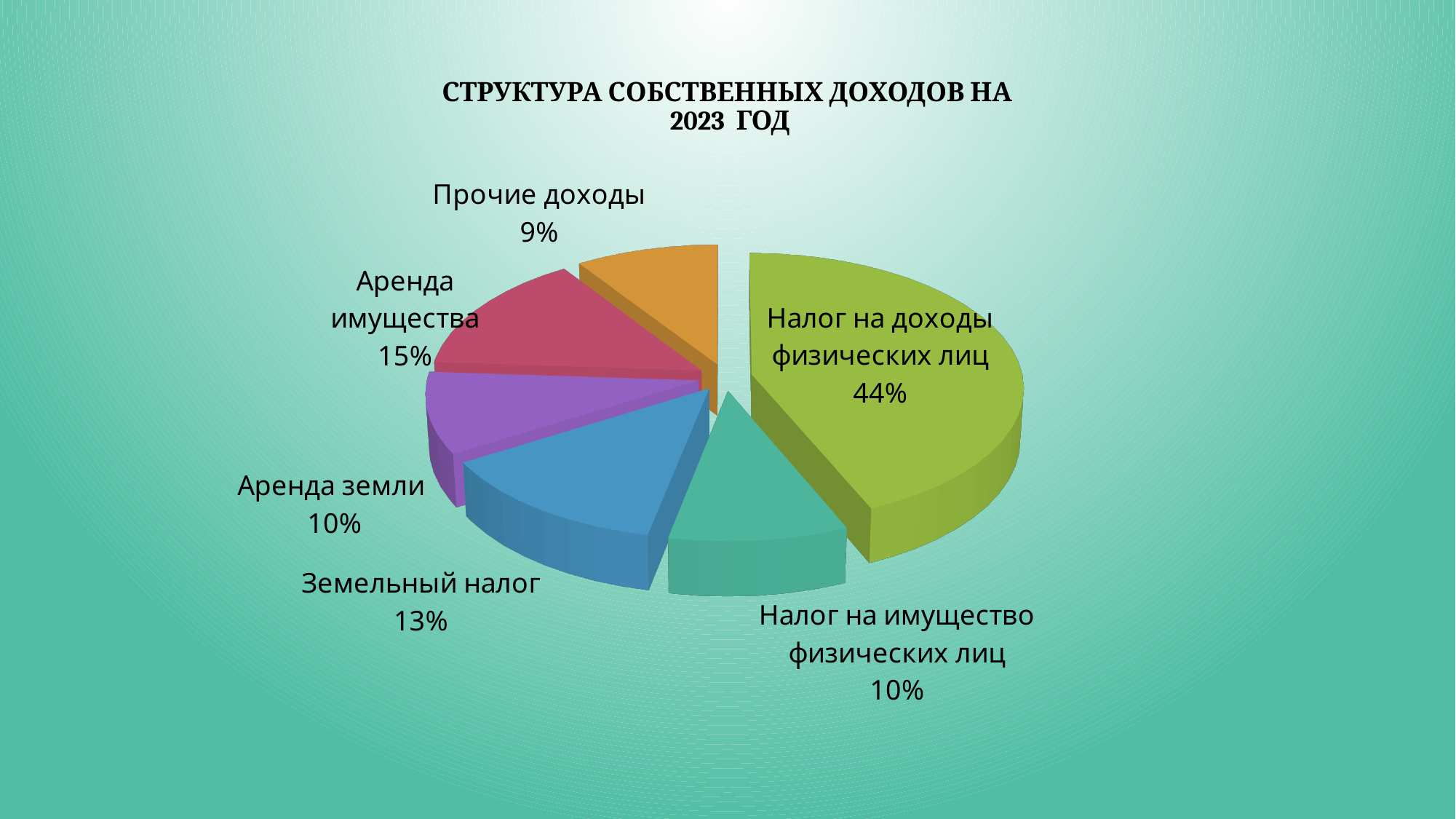
How many categories are shown in the pie chart? 6 Which category has the largest share of the pie? Налог на доходы физических лиц What share does Прочие доходы have in the pie chart? 9% What share does Аренда имущества have in the pie chart? 15% What share does Земельный налог have in the pie chart? 13% What is the difference in percentage points between Налог на доходы физических лиц and Аренда имущества? 29 What share does Налог на имущество физических лиц have in the pie chart? 10% Which is larger: the share of Земельный налог or the share of Аренда земли? Земельный налог Which category has the smallest share of the pie? Прочие доходы What share does Налог на доходы физических лиц have in the pie chart? 44% What is the title of the chart? СТРУКТУРА СОБСТВЕННЫХ ДОХОДОВ НА 2023 ГОД What kind of chart is shown on the slide? pie chart